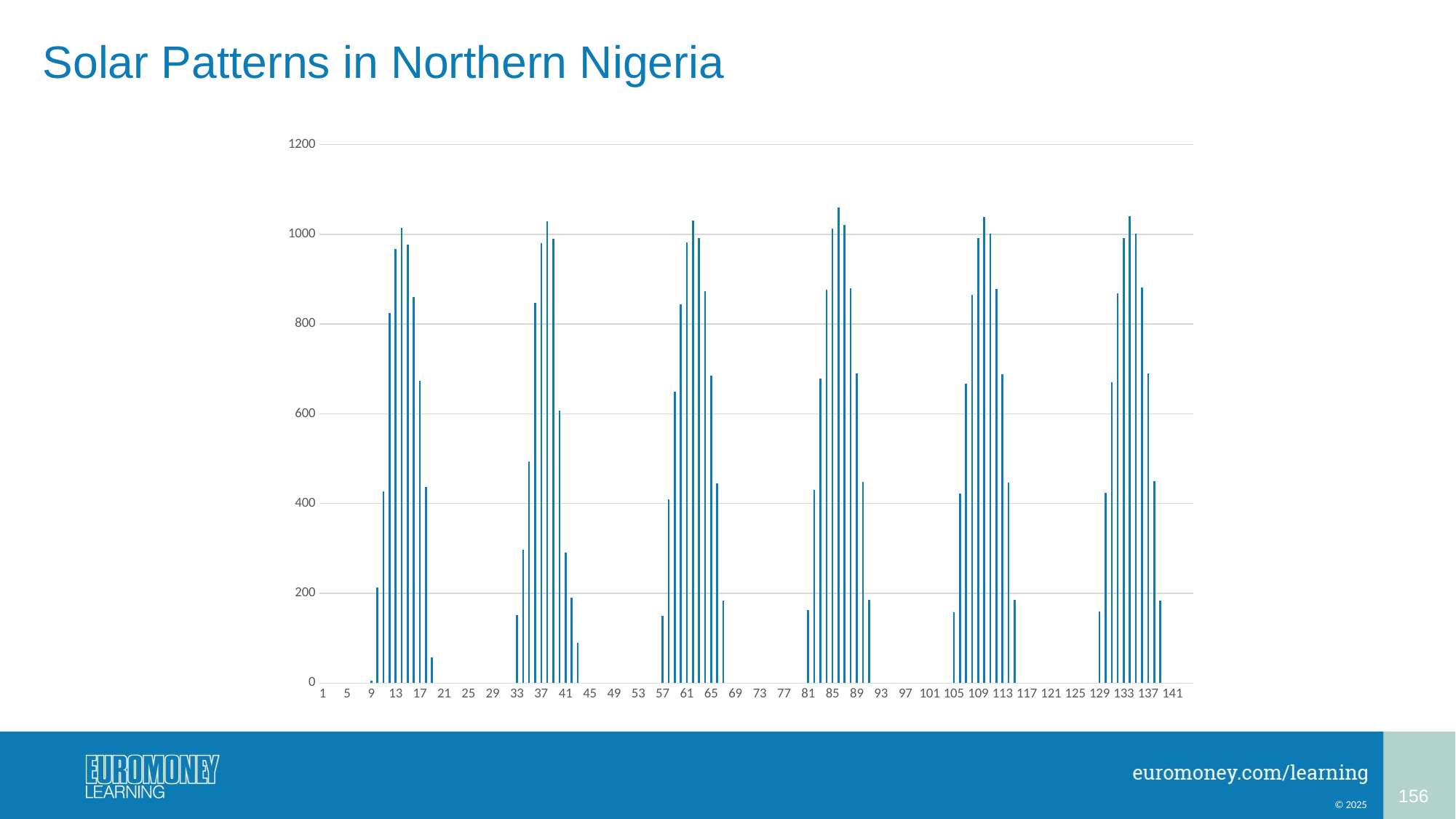
Is the value of the bar at x = 41 greater or less than 200? greater Is the value of the bar at x = 129 greater or less than 200? less Is the value of the bar at x = 81 greater or less than 200? less What is the highest value shown on the y axis? 1200 How many distinct clusters (peaks) of bars appear across the x axis? 6 What kind of chart is shown on the slide? bar chart What is the title of the slide containing the chart? Solar Patterns in Northern Nigeria